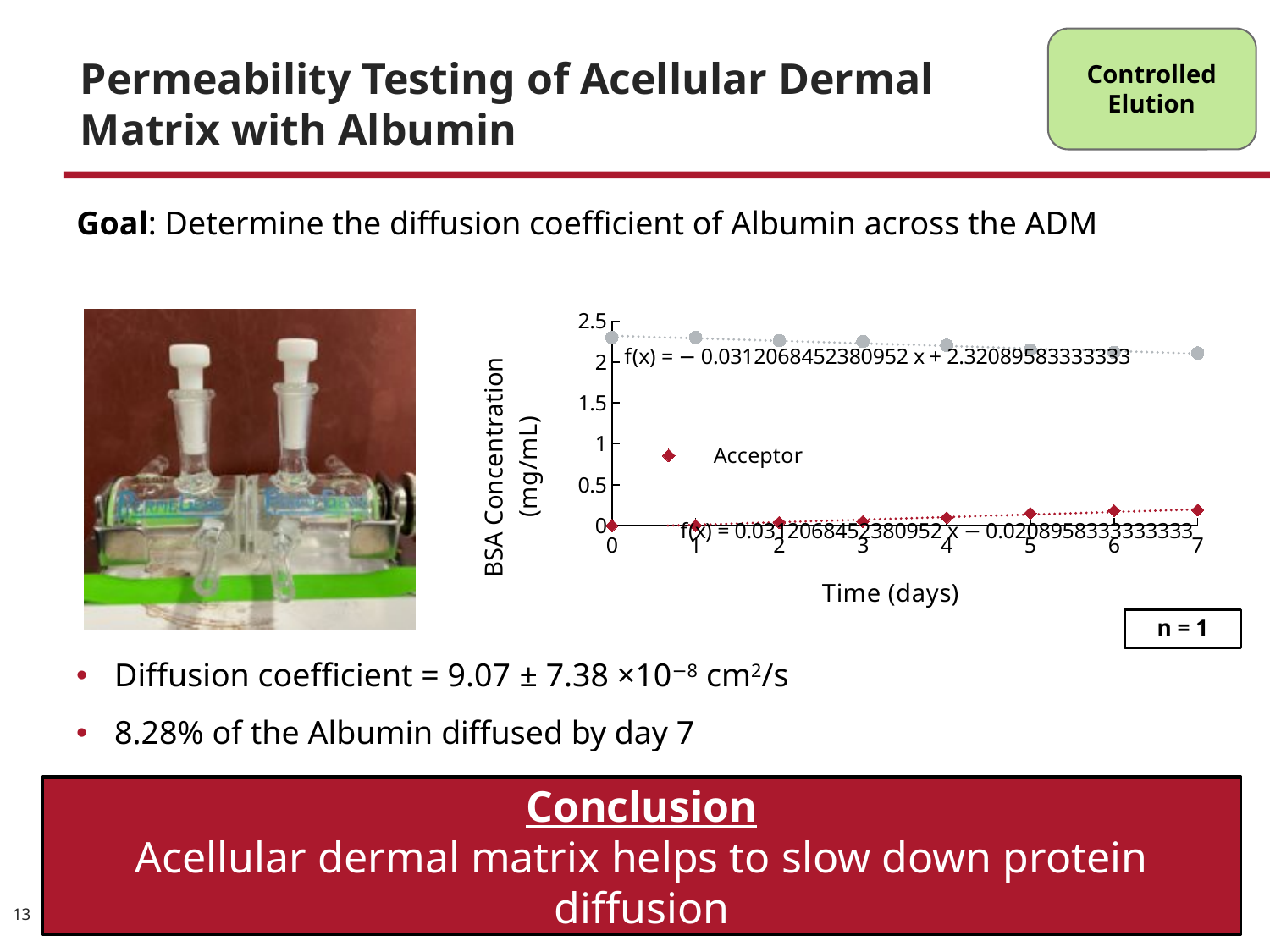
At day 3, which series has the larger value, the Acceptor series or the grey (upper) series? the grey (upper) series What kind of chart is shown on the slide? scatter chart Is the value of the grey (upper) series at day 7 greater or less than 2.5 mg/mL? less What is the label of the x axis of the chart? Time (days) What is the label of the y axis of the chart? BSA Concentration (mg/mL) What is the trendline equation printed for the Acceptor series? f(x) = 0.0312068452380952 x − 0.0208958333333333 Is the value of the grey (upper) series at day 0 greater or less than 2 mg/mL? greater Is the Acceptor value at day 7 greater or less than 0.5 mg/mL? less Do the Acceptor values rise or fall as time increases from day 0 to day 7? rise How many time points are plotted for the Acceptor series? 8 What is the trendline equation printed for the grey (upper) series? f(x) = − 0.0312068452380952 x + 2.32089583333333 Do the values of the grey (upper) series rise or fall as time increases from day 0 to day 7? fall